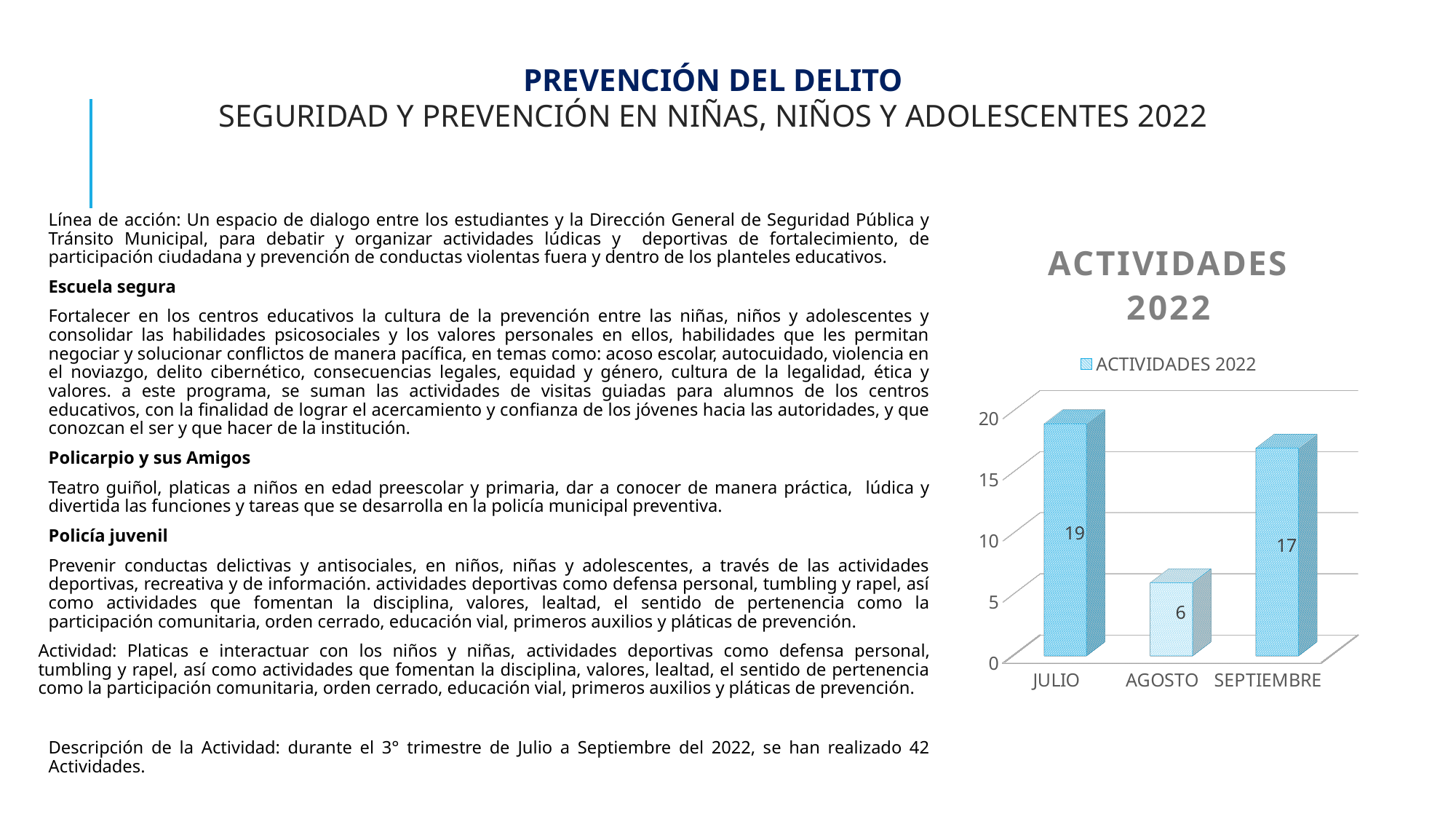
How many months are shown in the ACTIVIDADES 2022 chart? 3 What is the difference between the values for SEPTIEMBRE and AGOSTO in the ACTIVIDADES 2022 chart? 11 What is the value for JULIO in the ACTIVIDADES 2022 chart? 19 Which month has the lowest value in the ACTIVIDADES 2022 chart? AGOSTO Is the value for AGOSTO in the ACTIVIDADES 2022 chart greater or less than 10? less How many series does the legend of the ACTIVIDADES 2022 chart list? 1 Which is larger in the ACTIVIDADES 2022 chart, the value for JULIO or the value for SEPTIEMBRE? JULIO Which month has the highest value in the ACTIVIDADES 2022 chart? JULIO What kind of chart is the ACTIVIDADES 2022 chart? bar chart What is the difference between the values for JULIO and AGOSTO in the ACTIVIDADES 2022 chart? 13 What is the value for SEPTIEMBRE in the ACTIVIDADES 2022 chart? 17 What is the value for AGOSTO in the ACTIVIDADES 2022 chart? 6